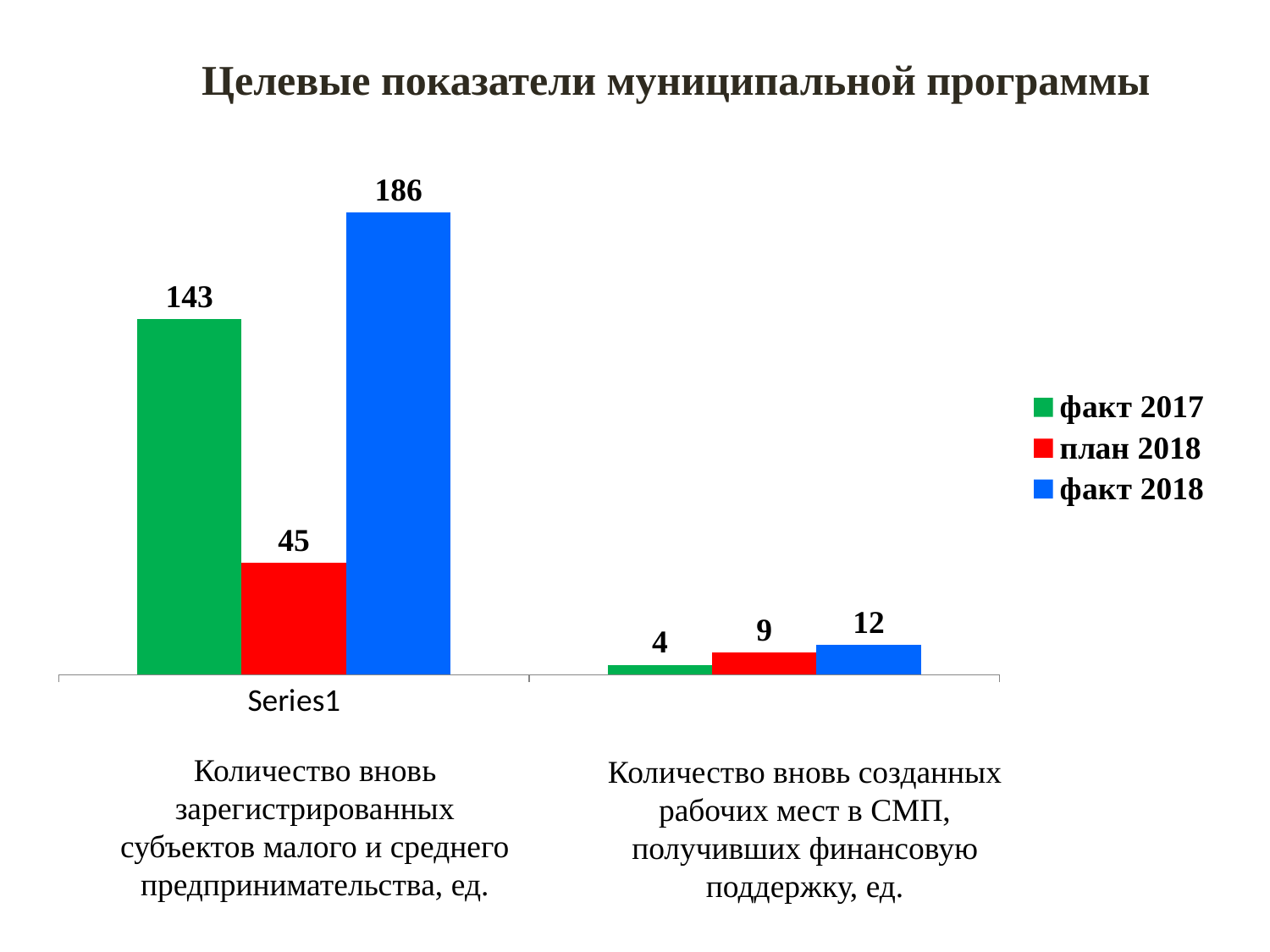
How many series does the legend list? 3 What is the value for факт 2018 in the second group (Количество вновь созданных рабочих мест в СМП)? 12 What is the difference between факт 2018 and план 2018 in the first group (Количество вновь зарегистрированных субъектов малого и среднего предпринимательства)? 141 Which series has the lowest value in the second group (Количество вновь созданных рабочих мест в СМП)? факт 2017 Which series has the highest value in the first group (Количество вновь зарегистрированных субъектов малого и среднего предпринимательства)? факт 2018 What is the value for факт 2018 in the first group (Количество вновь зарегистрированных субъектов малого и среднего предпринимательства)? 186 What is the value for план 2018 in the first group (Количество вновь зарегистрированных субъектов малого и среднего предпринимательства)? 45 What is the value for факт 2017 in the second group (Количество вновь созданных рабочих мест в СМП)? 4 What colour represents план 2018 in the legend? red What type of chart is shown on the slide? bar chart What is the value for факт 2017 in the first group (Количество вновь зарегистрированных субъектов малого и среднего предпринимательства)? 143 In the second group (Количество вновь созданных рабочих мест в СМП), which is larger: план 2018 or факт 2018? факт 2018